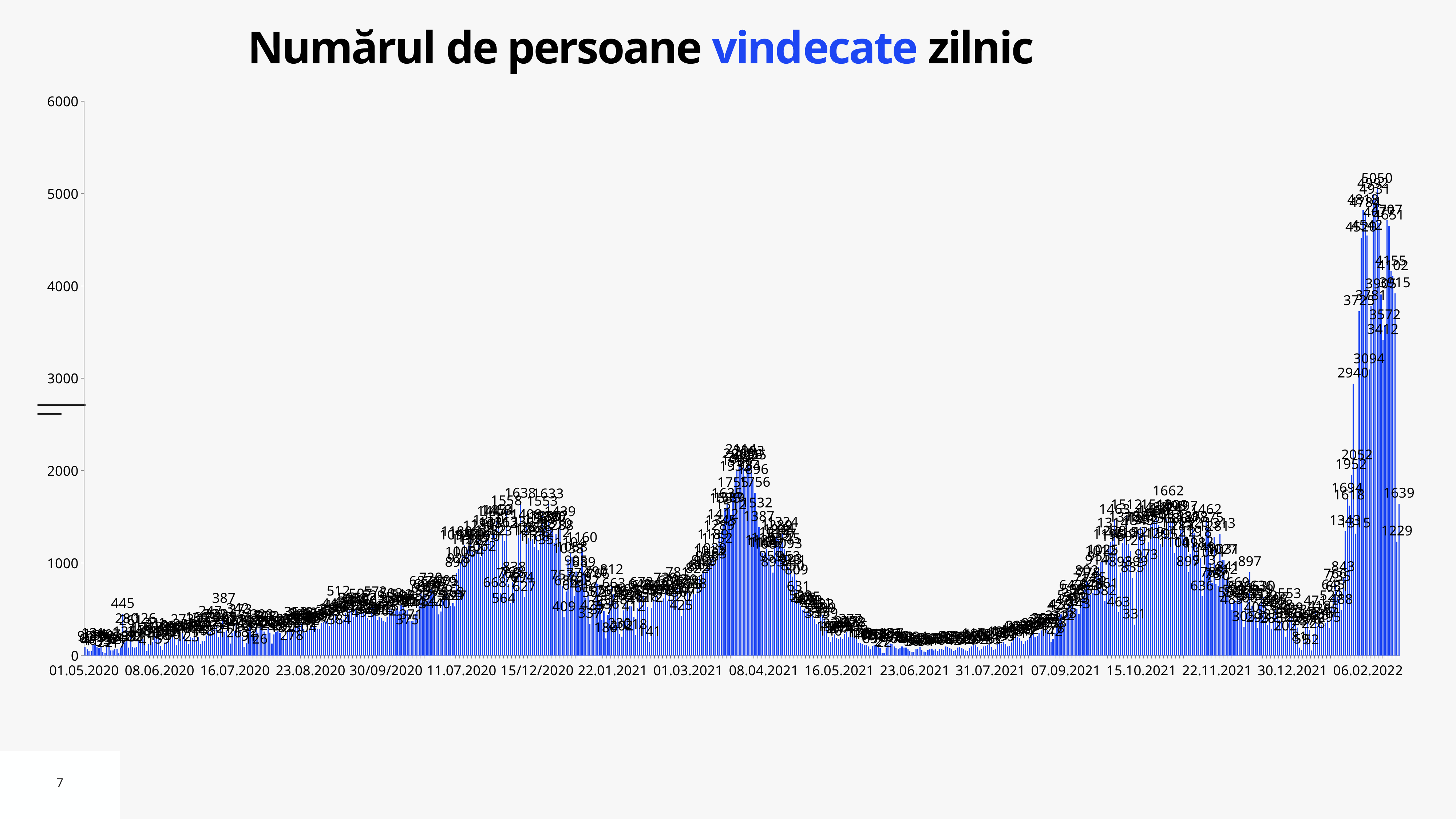
Which peak is higher: the one near 08.04.2021 or the one near 06.02.2022? 06.02.2022 Do the values rise or fall between 30.12.2021 and 06.02.2022? rise What is the title of the chart? Numărul de persoane vindecate zilnic Is the tallest bar on the chart greater or less than 5000? greater Are the bars around 23.06.2021 greater or less than 1000? less What kind of chart is shown on the slide? bar chart Is the peak near 08.04.2021 greater or less than 1000? greater Around which x-axis date label do the tallest bars of the chart appear? 06.02.2022 Do the values rise or fall between 08.04.2021 and 23.06.2021? fall What is the highest tick value shown on the vertical axis? 6000 What is the highest value labeled on the chart? 5050